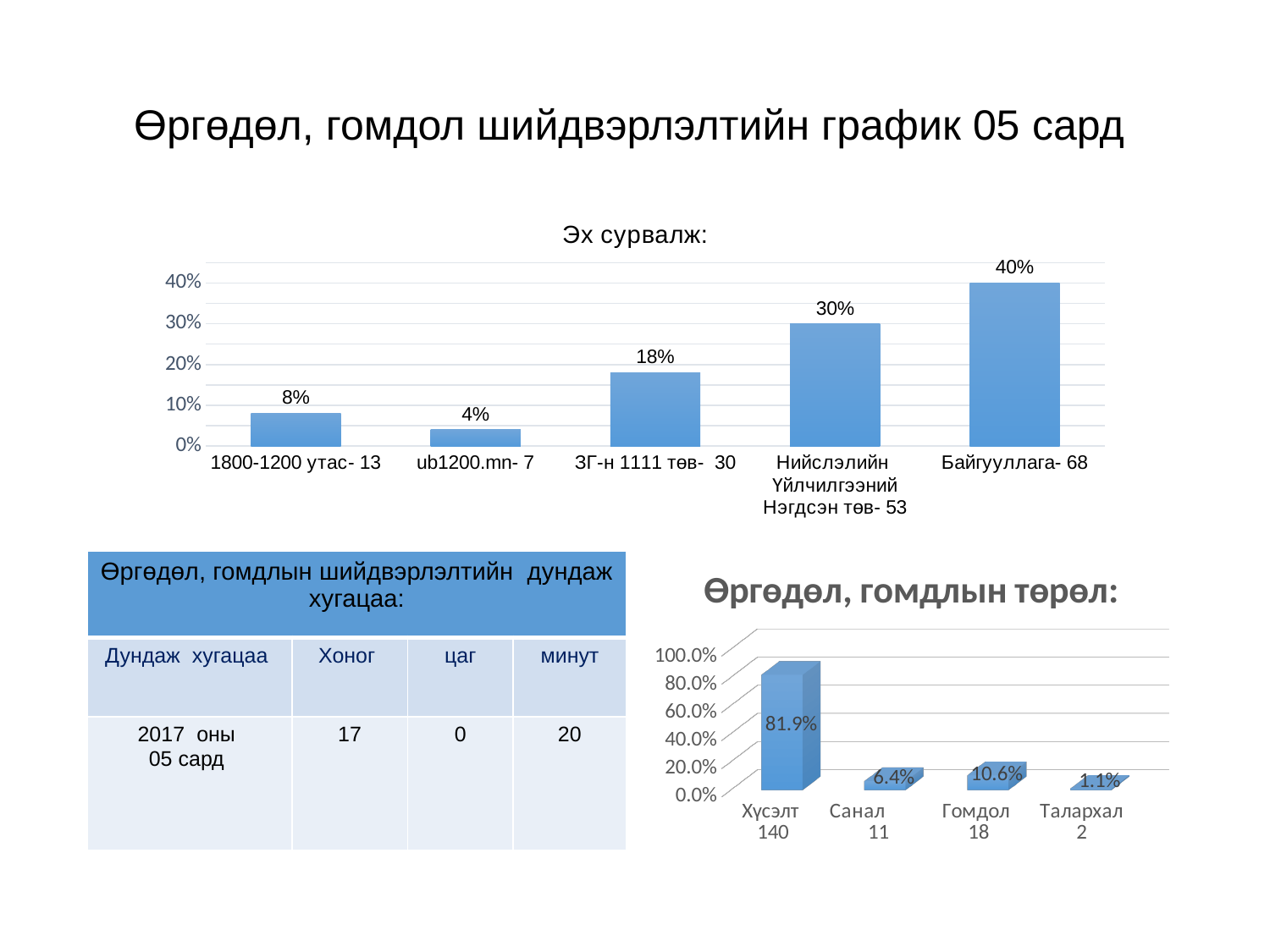
In the chart titled "Өргөдөл, гомдлын төрөл:", which category has the highest value? Хүсэлт 140 In the chart titled "Эх сурвалж:", is the value for "1800-1200 утас- 13" greater or less than 10%? less In the chart titled "Эх сурвалж:", what is the value for "ub1200.mn- 7"? 4% In the chart titled "Өргөдөл, гомдлын төрөл:", which is larger, the value for "Санал 11" or the value for "Талархал 2"? Санал 11 In the chart titled "Өргөдөл, гомдлын төрөл:", what is the value for "Гомдол 18"? 10.6% In the chart titled "Эх сурвалж:", how many categories are shown? 5 In the chart titled "Эх сурвалж:", what is the difference between the values for "Нийслэлийн Үйлчилгээний Нэгдсэн төв- 53" and "ЗГ-н 1111 төв- 30"? 12% In the chart titled "Эх сурвалж:", which category has the lowest value? ub1200.mn- 7 In the chart titled "Өргөдөл, гомдлын төрөл:", how many categories are shown? 4 In the chart titled "Эх сурвалж:", which category has the highest value? Байгууллага- 68 In the chart titled "Эх сурвалж:", what is the value for "Байгууллага- 68"? 40% What kind of chart is the chart titled "Өргөдөл, гомдлын төрөл:"? bar chart